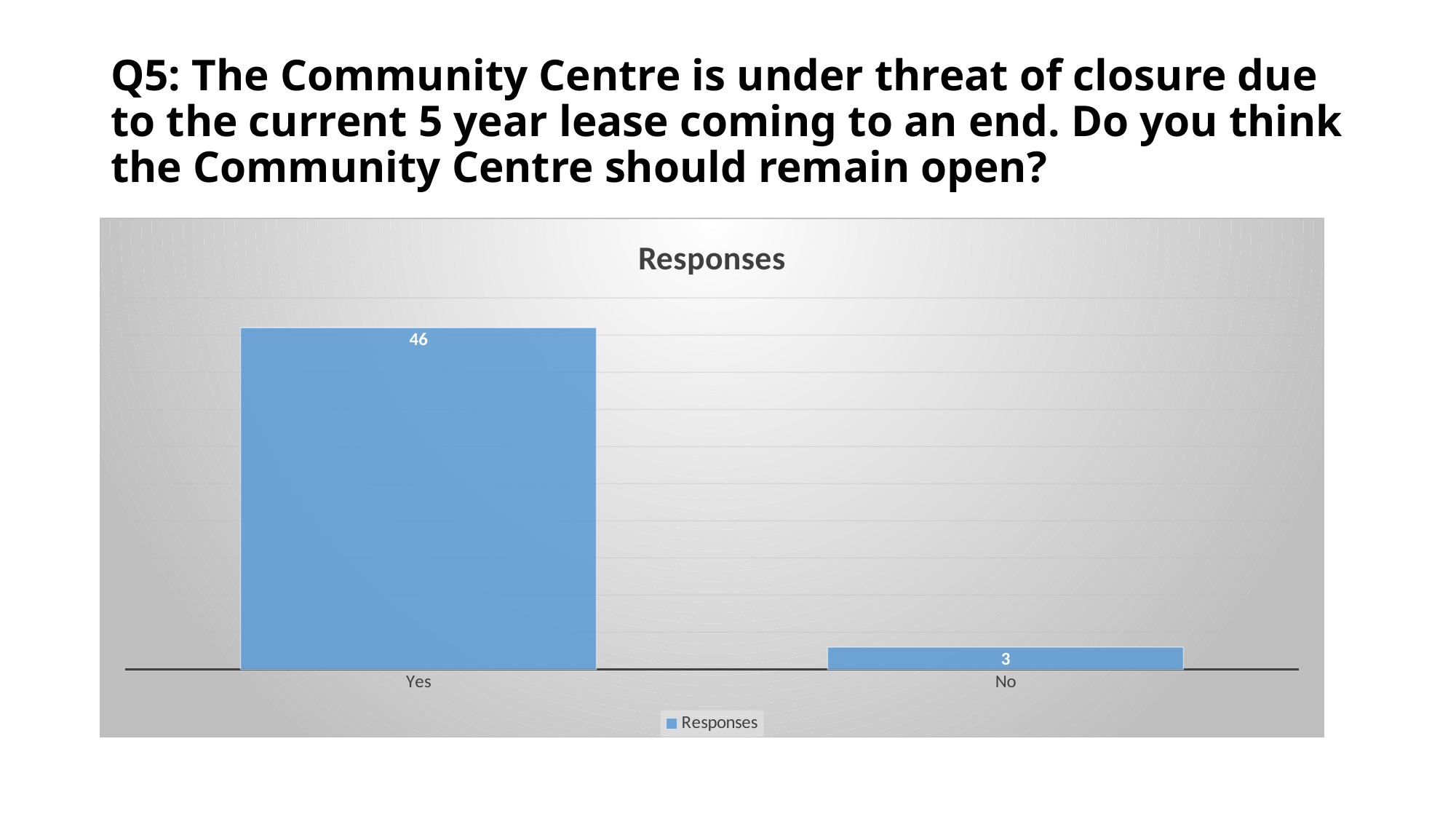
What is the total of the values for Yes and No? 49 What is the title of the chart? Responses How many series does the legend list? 1 What kind of chart is shown on the slide? Bar chart Which is larger, the value for Yes or the value for No? Yes How many categories are shown on the x axis? 2 What is the name of the series listed in the legend? Responses Which category has the highest value? Yes Which category has the lowest value? No What is the value for Yes? 46 What is the difference between the values for Yes and No? 43 What is the value for No? 3